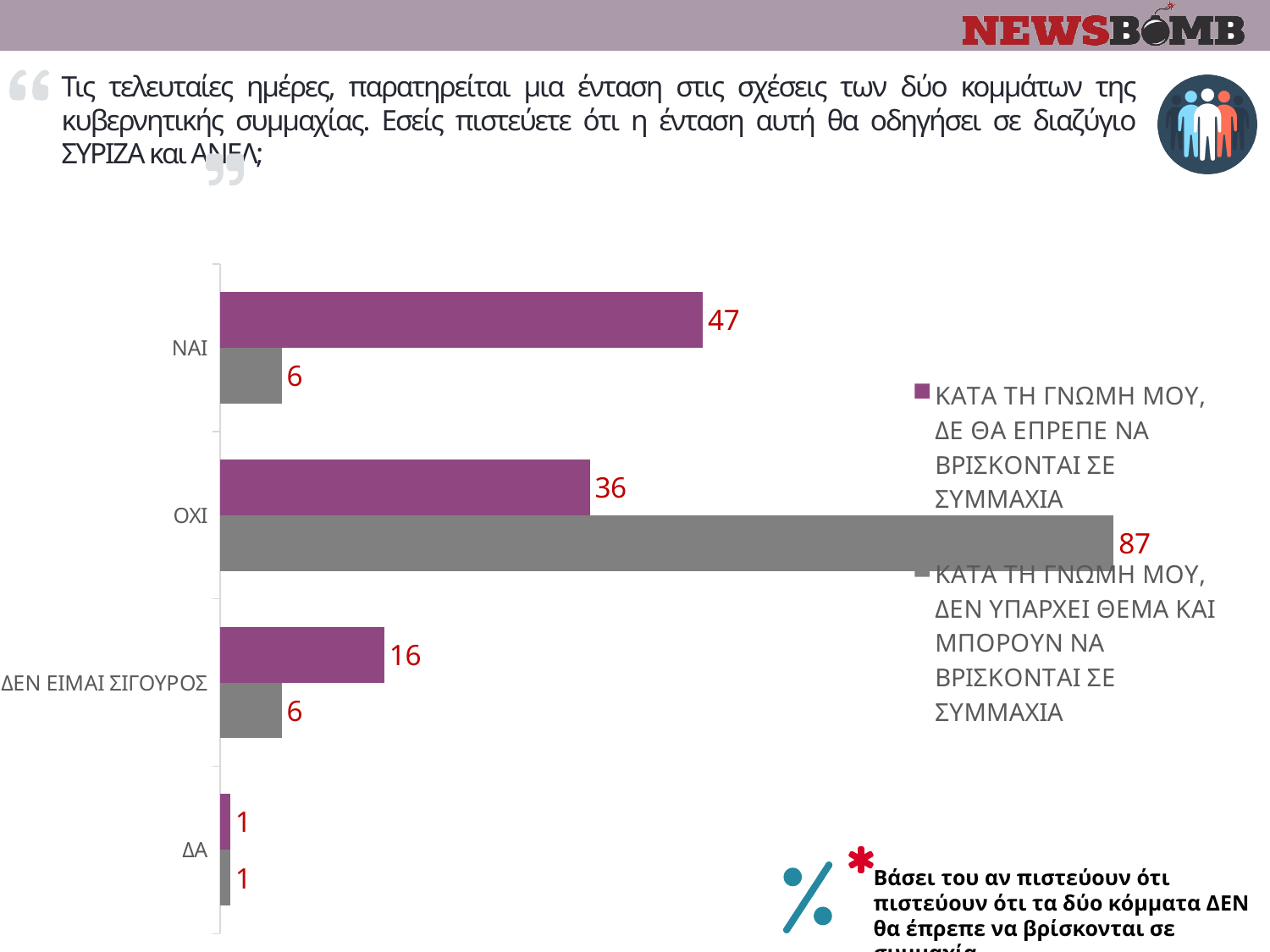
For ΝΑΙ, which series has the larger value? ΚΑΤΑ ΤΗ ΓΝΩΜΗ ΜΟΥ, ΔΕ ΘΑ ΕΠΡΕΠΕ ΝΑ ΒΡΙΣΚΟΝΤΑΙ ΣΕ ΣΥΜΜΑΧΙΑ What is the value for ΔΕΝ ΕΙΜΑΙ ΣΙΓΟΥΡΟΣ in the series 'ΚΑΤΑ ΤΗ ΓΝΩΜΗ ΜΟΥ, ΔΕ ΘΑ ΕΠΡΕΠΕ ΝΑ ΒΡΙΣΚΟΝΤΑΙ ΣΕ ΣΥΜΜΑΧΙΑ'? 16 What is the value for ΔΑ in the series 'ΚΑΤΑ ΤΗ ΓΝΩΜΗ ΜΟΥ, ΔΕΝ ΥΠΑΡΧΕΙ ΘΕΜΑ ΚΑΙ ΜΠΟΡΟΥΝ ΝΑ ΒΡΙΣΚΟΝΤΑΙ ΣΕ ΣΥΜΜΑΧΙΑ'? 1 How many categories are shown on the chart? 4 Which category has the highest value in the series 'ΚΑΤΑ ΤΗ ΓΝΩΜΗ ΜΟΥ, ΔΕΝ ΥΠΑΡΧΕΙ ΘΕΜΑ ΚΑΙ ΜΠΟΡΟΥΝ ΝΑ ΒΡΙΣΚΟΝΤΑΙ ΣΕ ΣΥΜΜΑΧΙΑ'? ΟΧΙ What colour are the bars for the series 'ΚΑΤΑ ΤΗ ΓΝΩΜΗ ΜΟΥ, ΔΕΝ ΥΠΑΡΧΕΙ ΘΕΜΑ ΚΑΙ ΜΠΟΡΟΥΝ ΝΑ ΒΡΙΣΚΟΝΤΑΙ ΣΕ ΣΥΜΜΑΧΙΑ'? grey What type of chart is shown on the slide? bar chart What is the difference between the two series' values for ΟΧΙ? 51 What is the value for ΝΑΙ in the series 'ΚΑΤΑ ΤΗ ΓΝΩΜΗ ΜΟΥ, ΔΕ ΘΑ ΕΠΡΕΠΕ ΝΑ ΒΡΙΣΚΟΝΤΑΙ ΣΕ ΣΥΜΜΑΧΙΑ'? 47 How many series does the legend list? 2 Which category has the highest value in the series 'ΚΑΤΑ ΤΗ ΓΝΩΜΗ ΜΟΥ, ΔΕ ΘΑ ΕΠΡΕΠΕ ΝΑ ΒΡΙΣΚΟΝΤΑΙ ΣΕ ΣΥΜΜΑΧΙΑ'? ΝΑΙ What is the value for ΟΧΙ in the series 'ΚΑΤΑ ΤΗ ΓΝΩΜΗ ΜΟΥ, ΔΕΝ ΥΠΑΡΧΕΙ ΘΕΜΑ ΚΑΙ ΜΠΟΡΟΥΝ ΝΑ ΒΡΙΣΚΟΝΤΑΙ ΣΕ ΣΥΜΜΑΧΙΑ'? 87